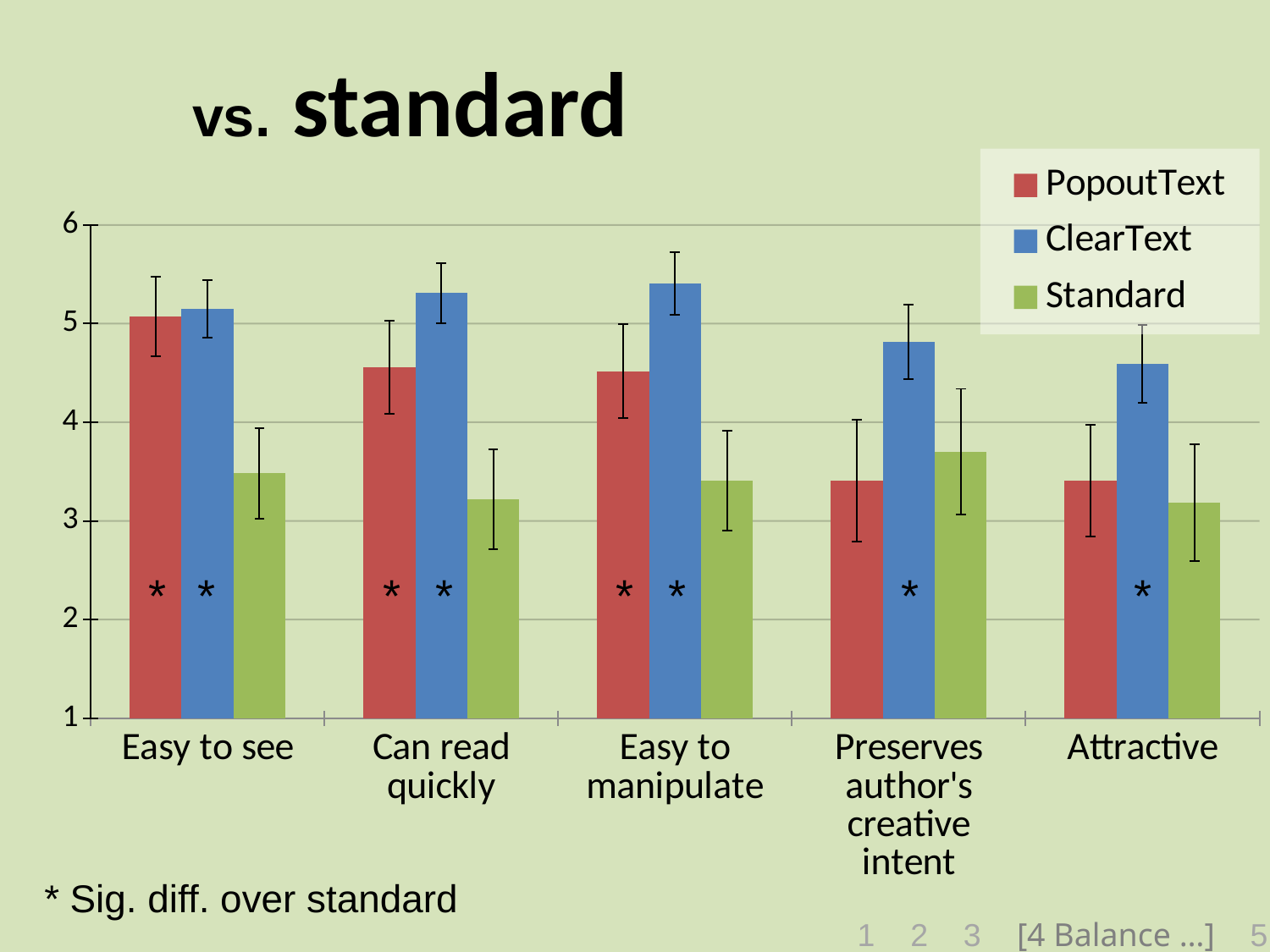
Which series has the highest value for Attractive? ClearText Is the ClearText value for Easy to manipulate greater or less than 5? greater For Can read quickly, which is larger: the PopoutText value or the ClearText value? ClearText How many categories are shown along the x axis? 5 Is the Standard value for Can read quickly greater or less than 4? less Is the PopoutText value for Easy to see greater or less than 4? greater What colour represents the Standard series in the legend? Green How many series does the legend list? 3 What kind of chart is shown on the slide? Bar chart For Preserves author's creative intent, which is larger: the PopoutText value or the Standard value? Standard Which series has the lowest value for Easy to see? Standard